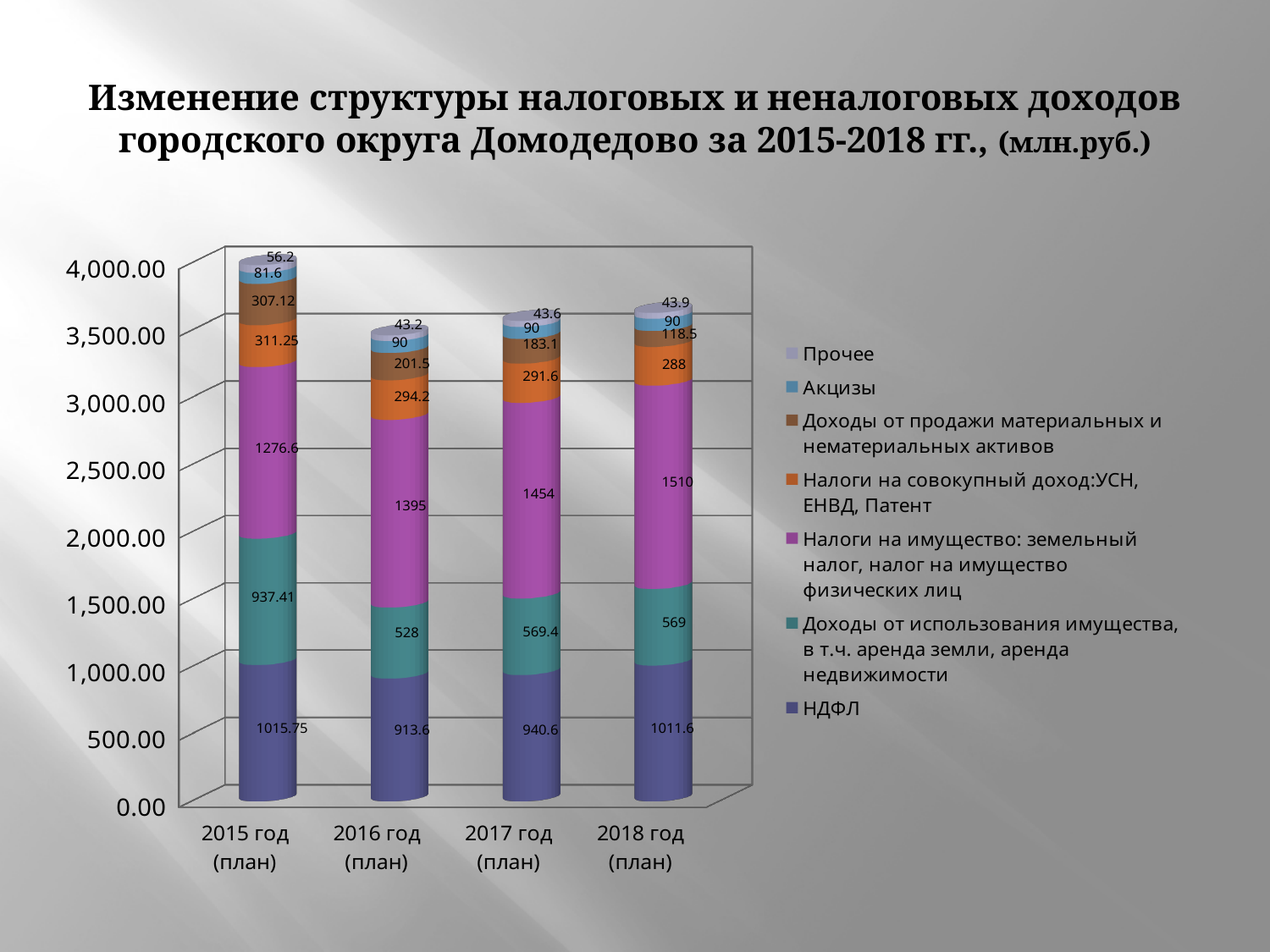
In which year is the value of НДФЛ the lowest? 2016 год (план) What is the value of Акцизы for 2016 год (план)? 90 What kind of chart is shown on the slide? Stacked bar chart What is the value of Налоги на имущество: земельный налог, налог на имущество физических лиц for 2018 год (план)? 1510 What is the difference between the values of Доходы от использования имущества for 2015 год (план) and 2016 год (план)? 409.41 Do the values of Налоги на имущество: земельный налог, налог на имущество физических лиц rise or fall from 2015 to 2018? Rise Which year has the larger value for Доходы от продажи материальных и нематериальных активов: 2015 год (план) or 2018 год (план)? 2015 год (план) In which year is the value of Налоги на имущество: земельный налог, налог на имущество физических лиц the highest? 2018 год (план) How many series does the legend list? 7 How many years (categories) are shown on the x axis? 4 What is the value of Прочее for 2017 год (план)? 43.6 What is the value of НДФЛ for 2015 год (план)? 1015.75